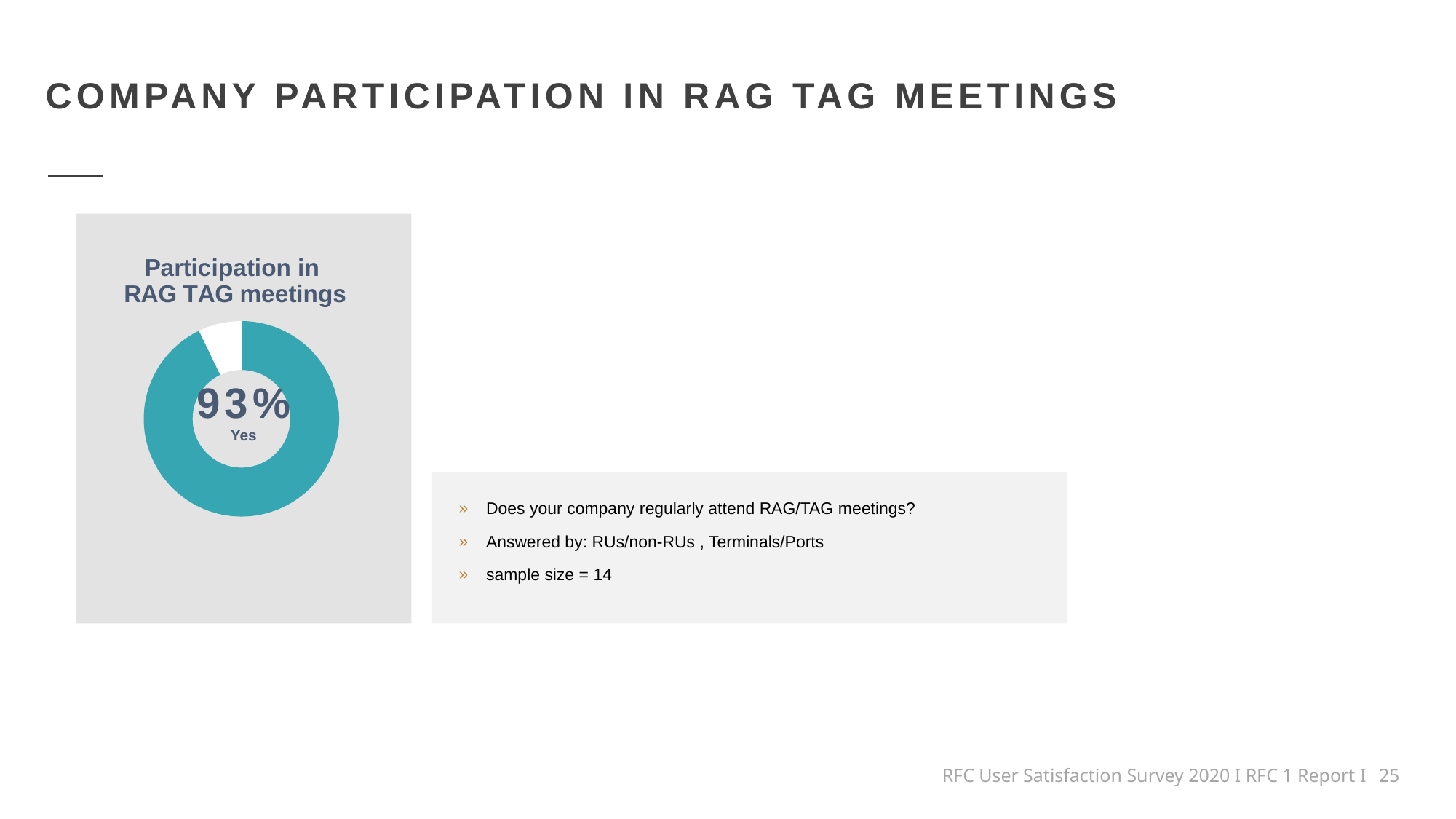
How many slices does the donut chart have? 2 What kind of chart is shown on the slide? Pie chart (donut) Is the share of Yes responses greater or less than 50%? greater Which response does the large teal slice of the donut chart represent? Yes What colour is the Yes slice of the donut chart? Teal Which slice of the donut chart is larger, the teal Yes slice or the white slice? The teal Yes slice What share of respondents answered Yes to participating in RAG TAG meetings? 93% What share of respondents did not answer Yes, based on the 93% shown? 7% What is the title of the chart? Participation in RAG TAG meetings What percentage is shown in the centre of the donut chart? 93%